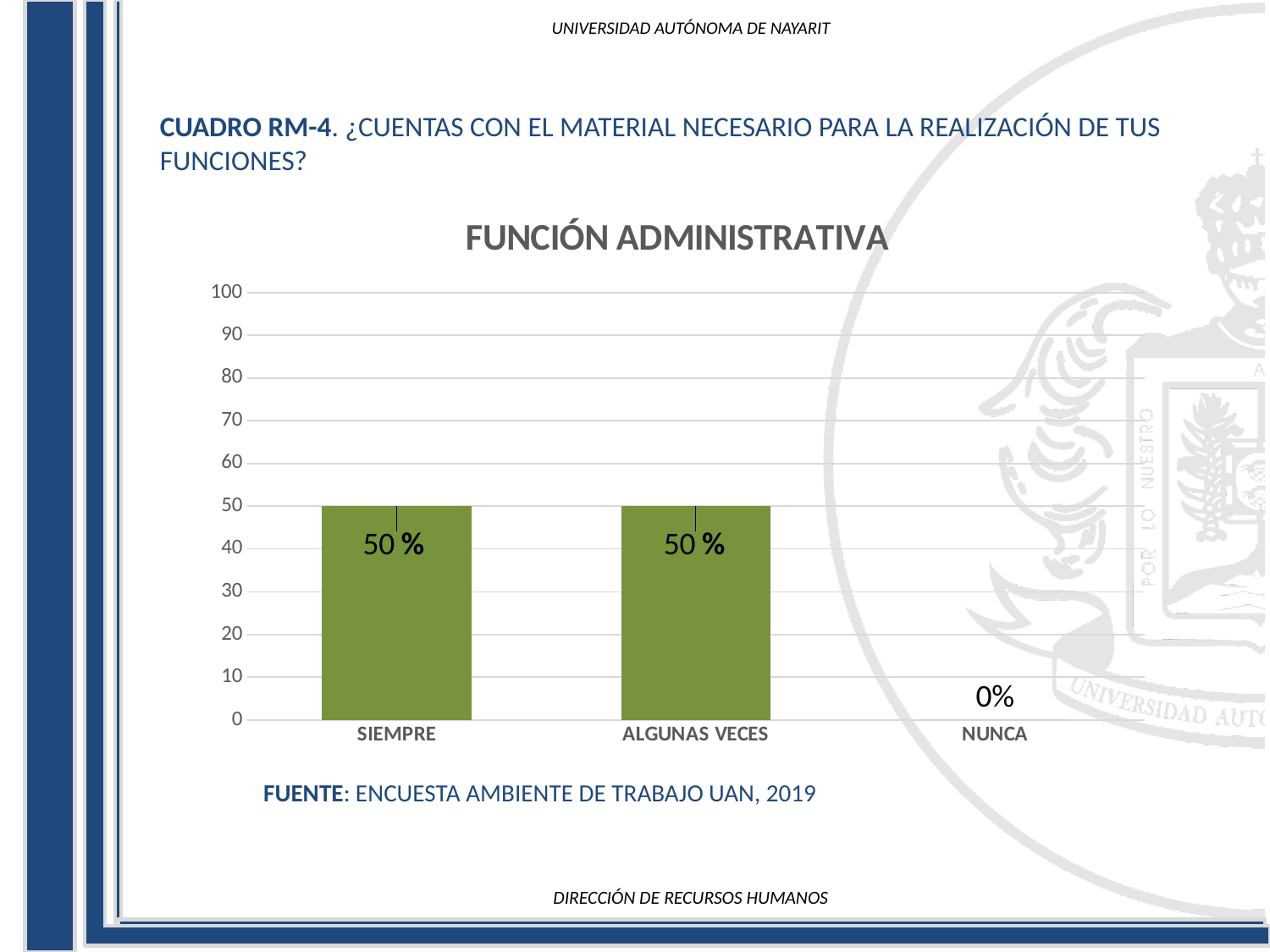
What is the difference between the values for SIEMPRE and NUNCA? 50 % Is the value for SIEMPRE greater or less than 60? less Which category has the lowest value? NUNCA What is the value for NUNCA? 0% What is the highest value shown on the y axis? 100 What kind of chart is shown? bar chart What is the value for SIEMPRE? 50 % What is the title of the chart? FUNCIÓN ADMINISTRATIVA What is the value for ALGUNAS VECES? 50 % Which is larger, the value for ALGUNAS VECES or the value for NUNCA? ALGUNAS VECES How many categories are shown on the x axis? 3